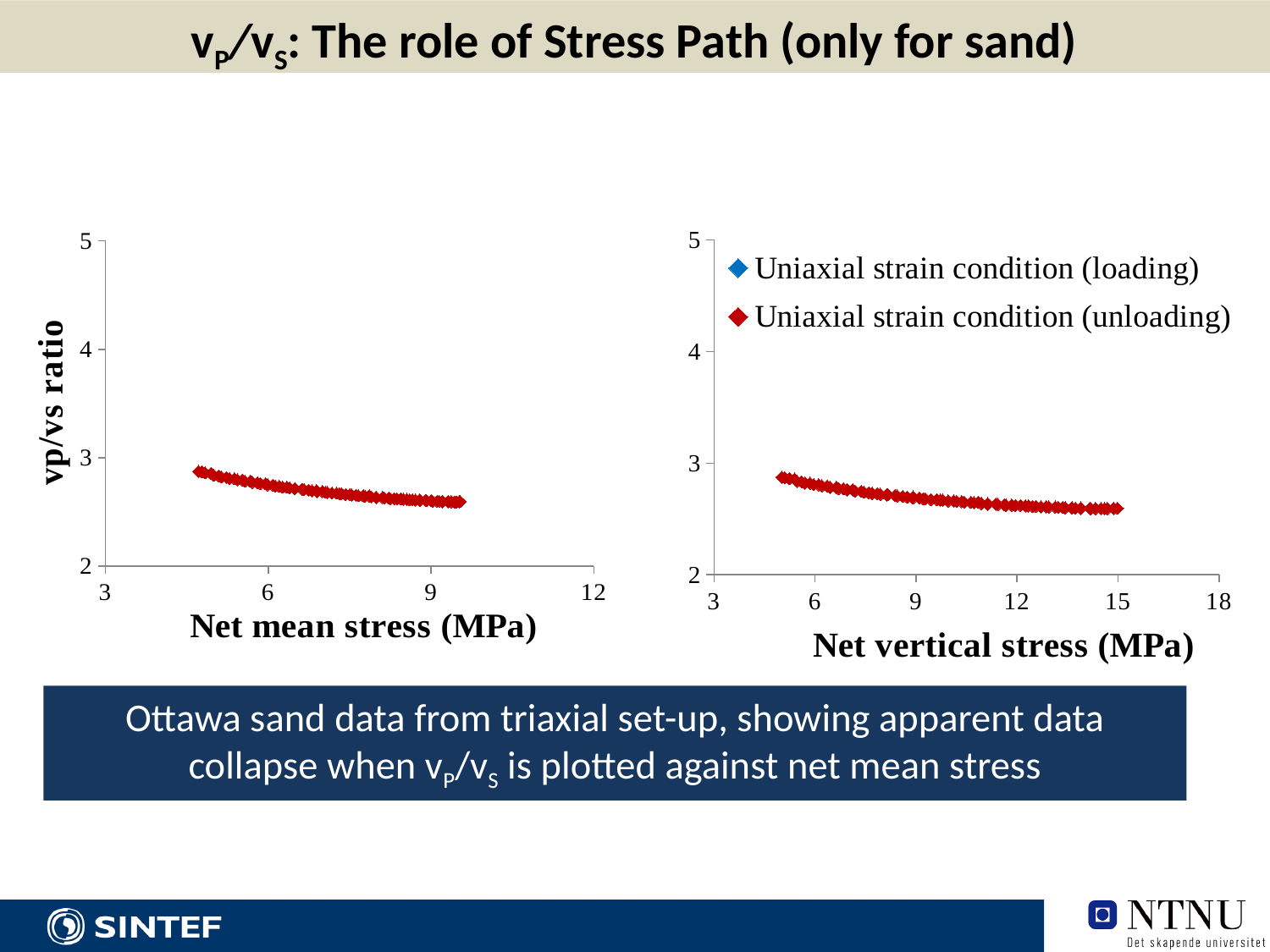
What is the x-axis label of the right chart? Net vertical stress (MPa) What is the x-axis label of the left chart? Net mean stress (MPa) In the left chart, is the vp/vs ratio at a net mean stress of 9 MPa greater or less than 3? less What kind of chart is the left chart (vp/vs ratio against net mean stress)? scatter chart In the left chart, is the vp/vs ratio at a net mean stress of 6 MPa greater or less than 2? greater What kind of chart is the right chart (vp/vs ratio against net vertical stress)? scatter chart In the right chart, is the vp/vs ratio at a net vertical stress of 6 MPa greater or less than 4? less In the right chart, does the vp/vs ratio rise or fall as net vertical stress increases? fall How many series does the legend of the right chart list? 2 In the left chart, does the vp/vs ratio rise or fall as net mean stress increases? fall